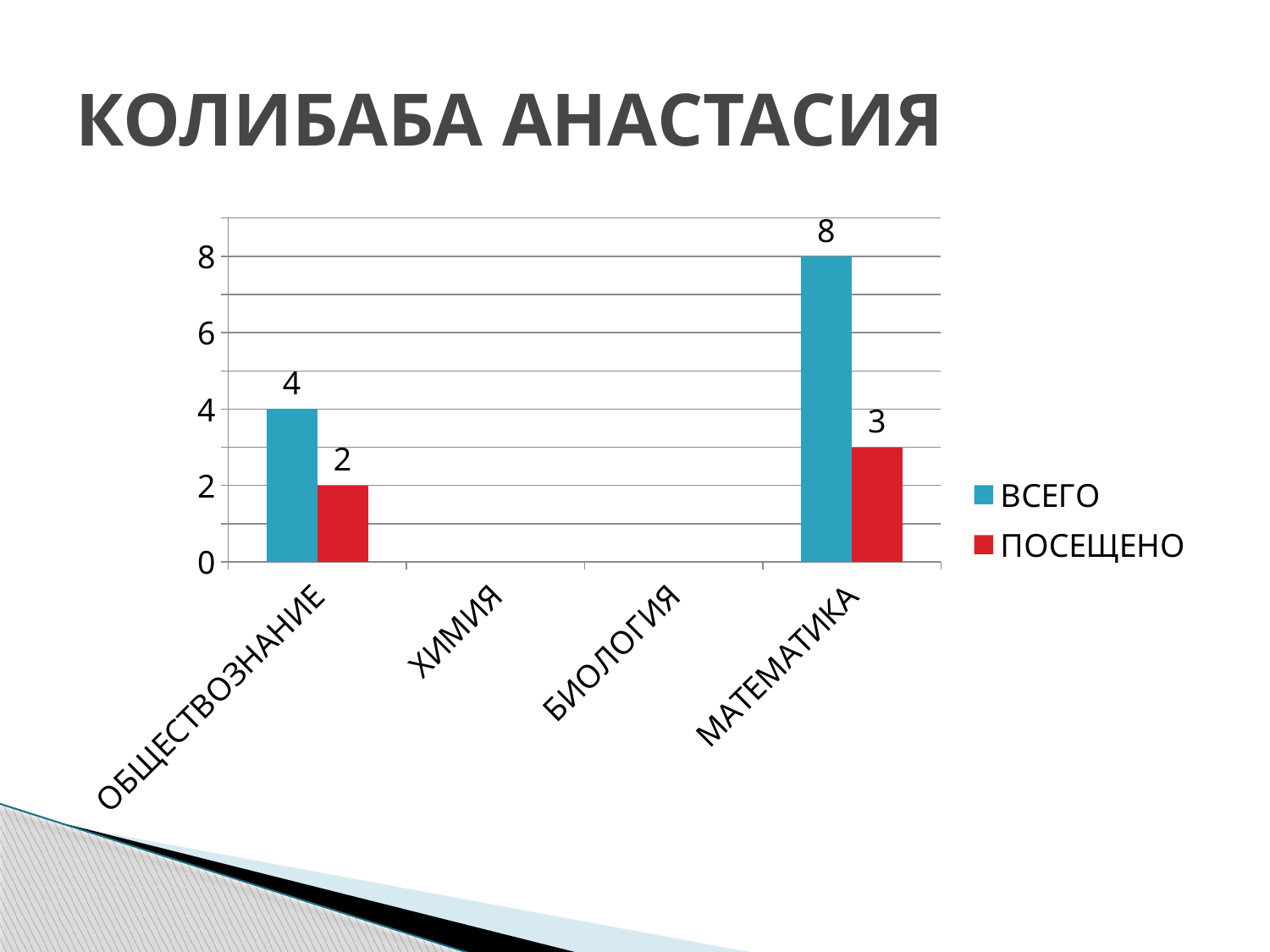
How many series does the legend list? 2 What kind of chart is shown on the slide? bar chart Which category has the highest ВСЕГО value? МАТЕМАТИКА What is the difference between the ВСЕГО values for МАТЕМАТИКА and ОБЩЕСТВОЗНАНИЕ? 4 Which is larger: the ПОСЕЩЕНО value for МАТЕМАТИКА or the ПОСЕЩЕНО value for ОБЩЕСТВОЗНАНИЕ? МАТЕМАТИКА What is the ВСЕГО value for МАТЕМАТИКА? 8 What is the ВСЕГО value for ОБЩЕСТВОЗНАНИЕ? 4 What is the difference between the ВСЕГО and ПОСЕЩЕНО values for МАТЕМАТИКА? 5 What is the title of the slide? КОЛИБАБА АНАСТАСИЯ What is the ПОСЕЩЕНО value for ОБЩЕСТВОЗНАНИЕ? 2 How many categories are shown on the x axis? 4 What is the ПОСЕЩЕНО value for МАТЕМАТИКА? 3